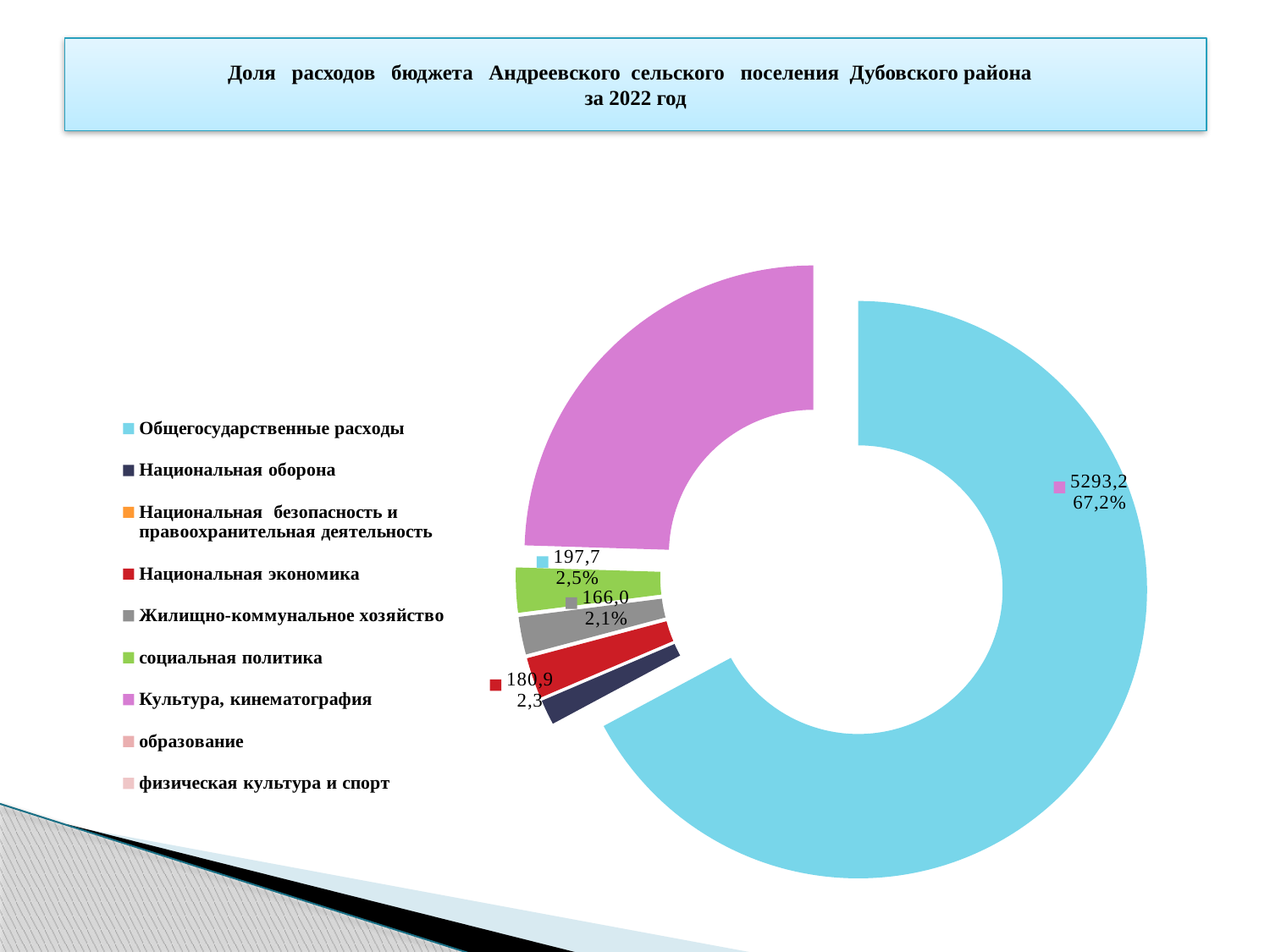
Which is larger, the slice for Национальная экономика or the slice for Жилищно-коммунальное хозяйство? Национальная экономика Which category has the largest slice of the pie? Общегосударственные расходы What kind of chart is shown on the slide? doughnut chart How many categories does the chart legend list? 9 What share of the pie does the largest slice have, according to its label? 67,2% What value is labelled on the largest slice of the pie? 5293,2 What share of the pie is labelled for Жилищно-коммунальное хозяйство? 2,1% What value is labelled for Национальная экономика? 180,9 Which is larger, the slice for Общегосударственные расходы or the slice for Культура, кинематография? Общегосударственные расходы What is the difference between the labelled values for Национальная экономика and Жилищно-коммунальное хозяйство? 14,9 What is the title of the chart on the slide? Доля расходов бюджета Андреевского сельского поселения Дубовского района за 2022 год What value is labelled for Жилищно-коммунальное хозяйство? 166,0